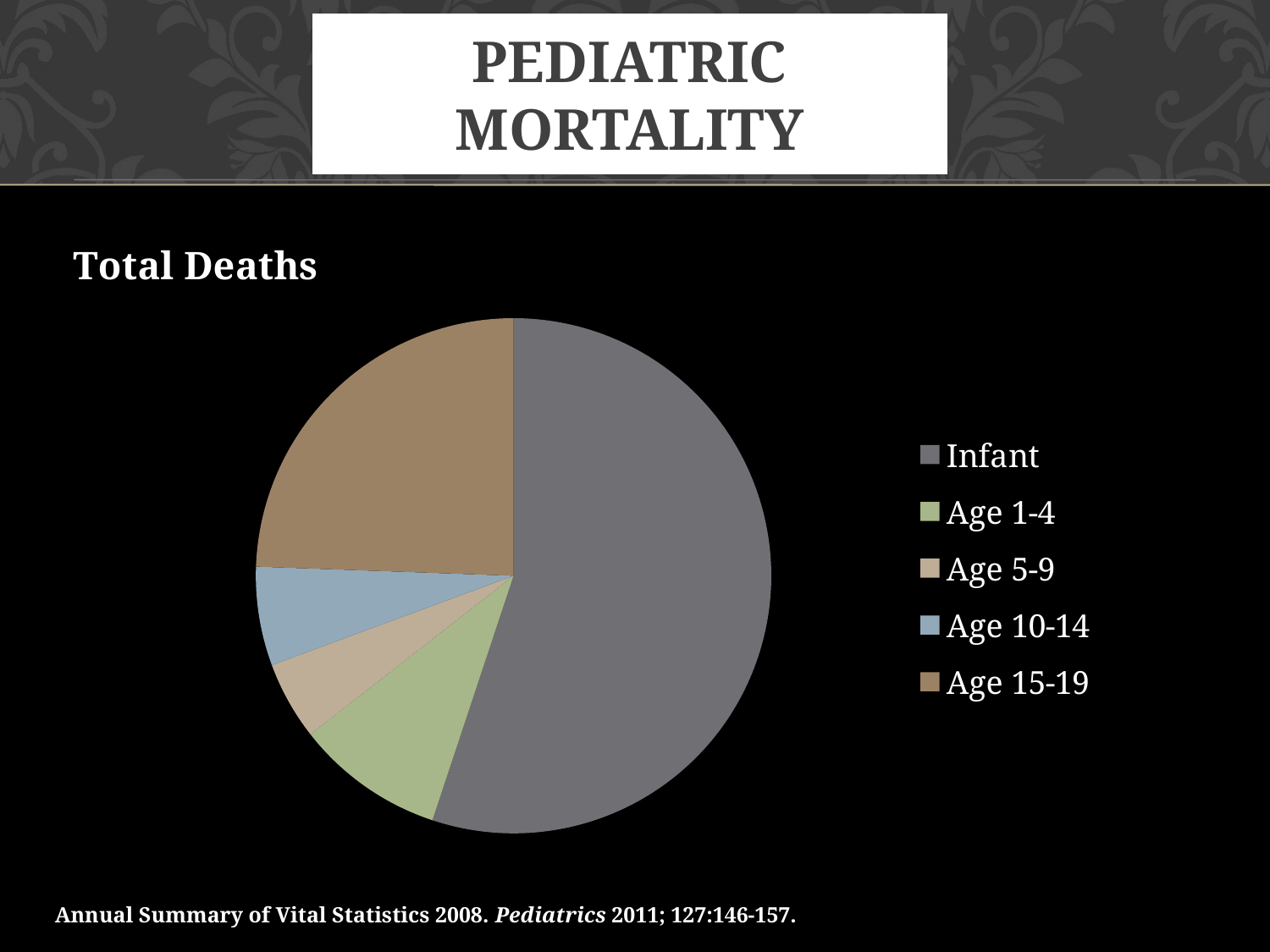
What is the title of the pie chart on the slide? Total Deaths Which is larger in the Total Deaths chart, the Age 1-4 slice or the Age 10-14 slice? Age 1-4 Which is larger in the Total Deaths chart, the Infant slice or the Age 15-19 slice? Infant Which is larger in the Total Deaths chart, the Age 15-19 slice or the Age 1-4 slice? Age 15-19 What kind of chart is shown on the slide? pie chart How many entries does the legend of the Total Deaths chart list? 5 Which category has the largest slice in the Total Deaths pie chart? Infant Which category is listed first in the legend of the Total Deaths chart? Infant How many categories does the Total Deaths pie chart show? 5